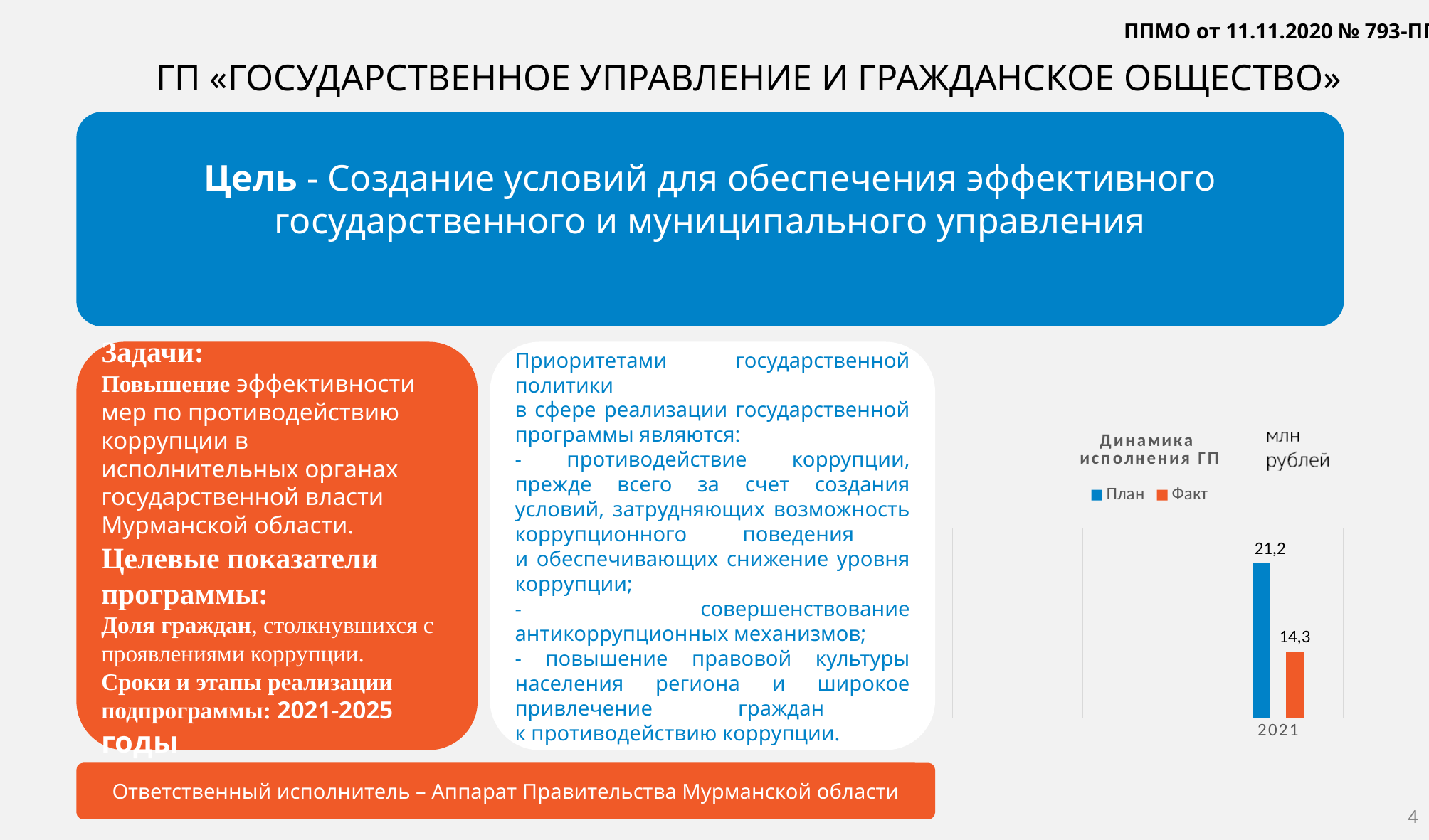
How many categories are shown on the x axis of the chart? 1 What is the План value for 2021 in the chart? 21,2 What is the difference between the План and Факт values for 2021? 6,9 What kind of chart is shown on the slide? Bar chart Which year is shown on the x axis of the chart? 2021 How many series does the chart legend list? 2 Which series has the larger value for 2021, План or Факт? План What unit is indicated next to the chart title? млн рублей What is the title of the chart? Динамика исполнения ГП What is the Факт value for 2021 in the chart? 14,3